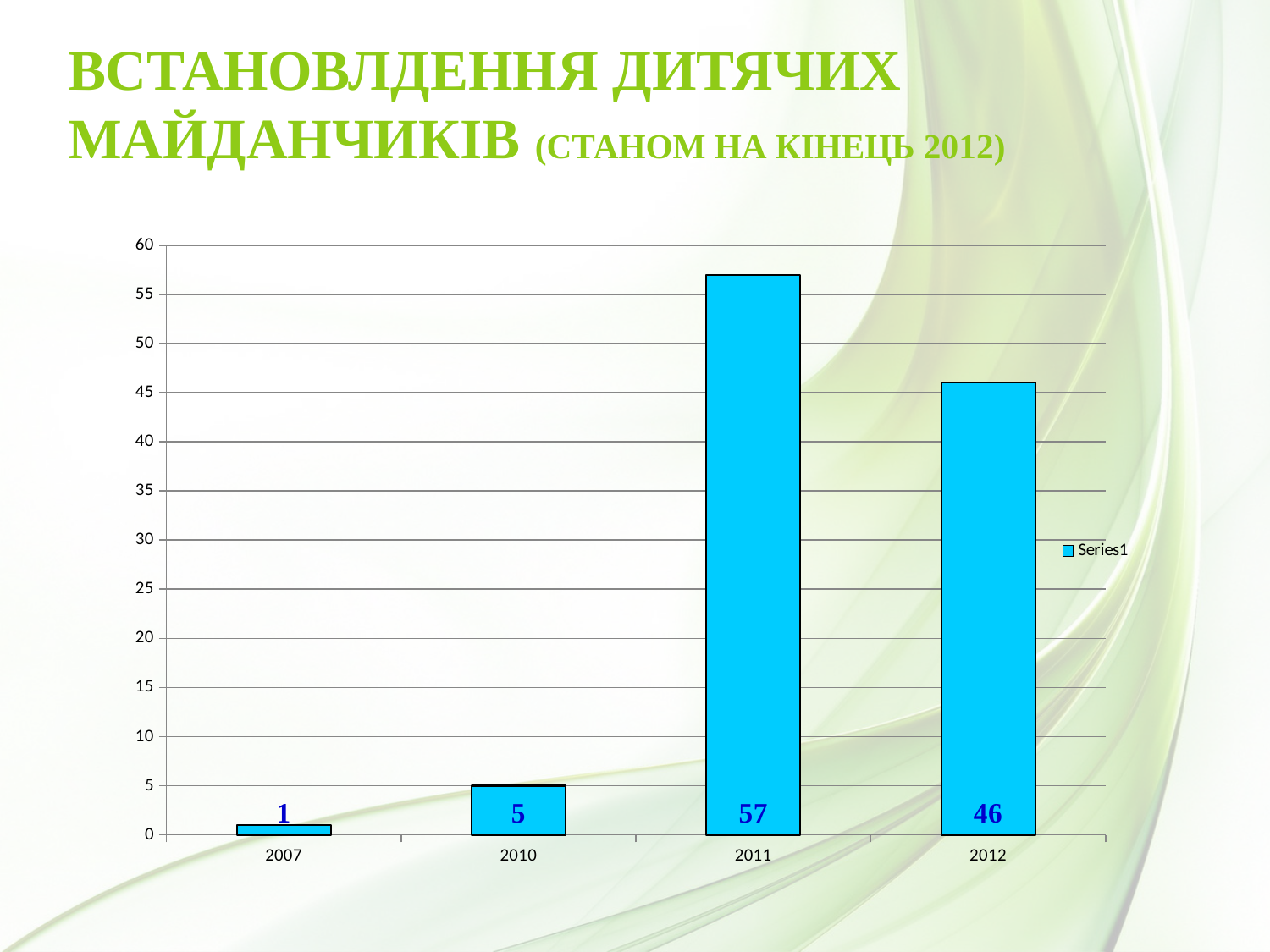
Which is larger, the value for 2010 or the value for 2012? 2012 What is the value for 2012? 46 What kind of chart is shown on the slide? bar chart How many series does the legend list? 1 Which year has the lowest value? 2007 Is the value for 2012 greater or less than 40? greater What is the value for 2011? 57 How many years are shown on the x axis? 4 What is the difference between the values for 2011 and 2012? 11 What is the value for 2007? 1 What is the name of the series in the legend? Series1 Which year has the highest value? 2011